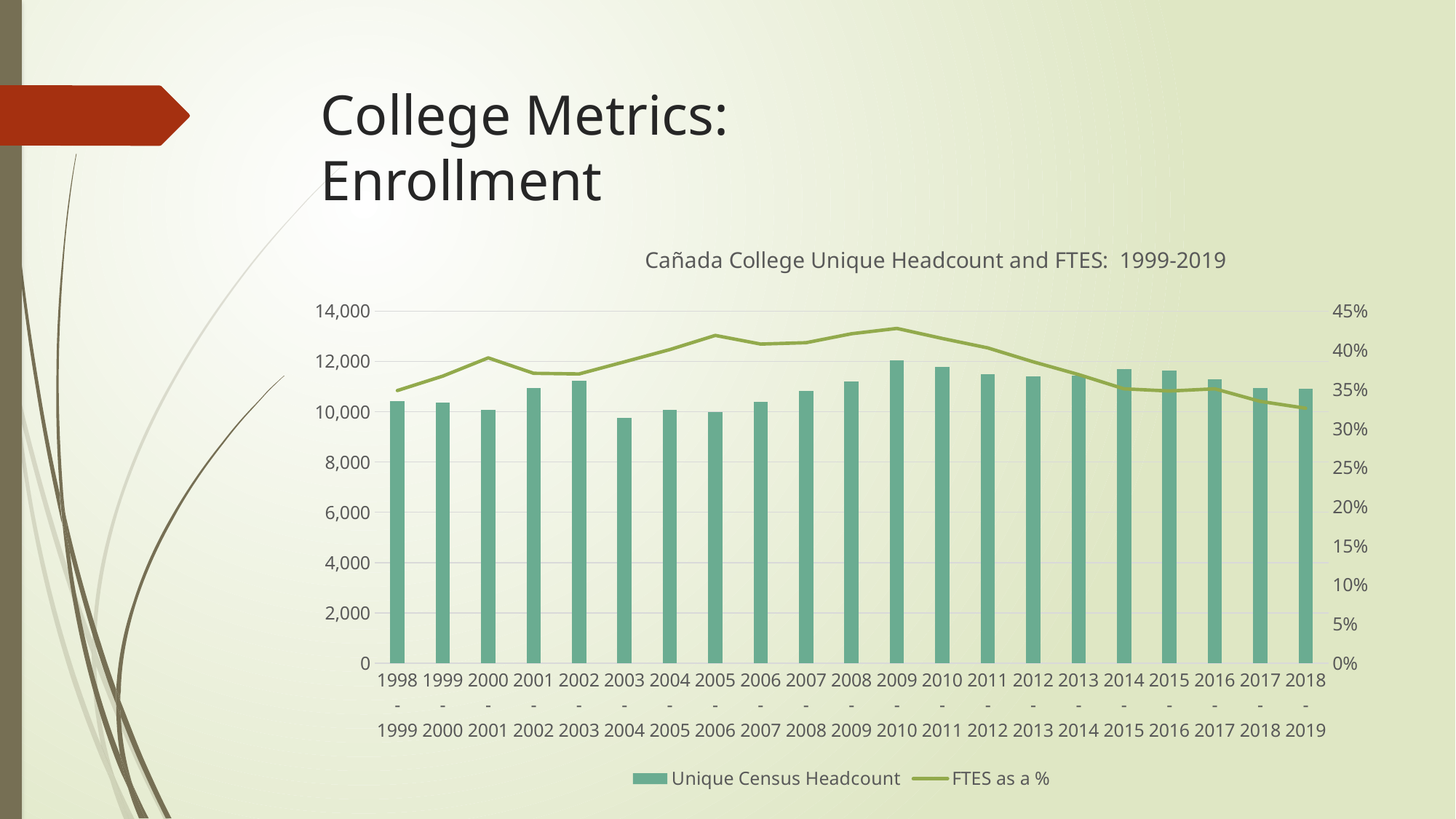
Which academic year has the highest Unique Census Headcount? 2009-2010 Which academic year has the lowest FTES as a %? 2018-2019 How many academic years are shown on the x axis? 21 Does the FTES as a % line rise or fall from 2009-2010 to 2018-2019? fall Is the FTES as a % for 2009-2010 greater or less than 40%? greater Which academic year has the highest FTES as a %? 2009-2010 How many series does the legend list? 2 What is the title of the chart? Cañada College Unique Headcount and FTES: 1999-2019 Which academic year has the lowest Unique Census Headcount? 2003-2004 Is the Unique Census Headcount for 2003-2004 greater or less than 10,000? less What are the two series named in the legend? Unique Census Headcount and FTES as a % What kind of chart is this? Combination bar and line chart